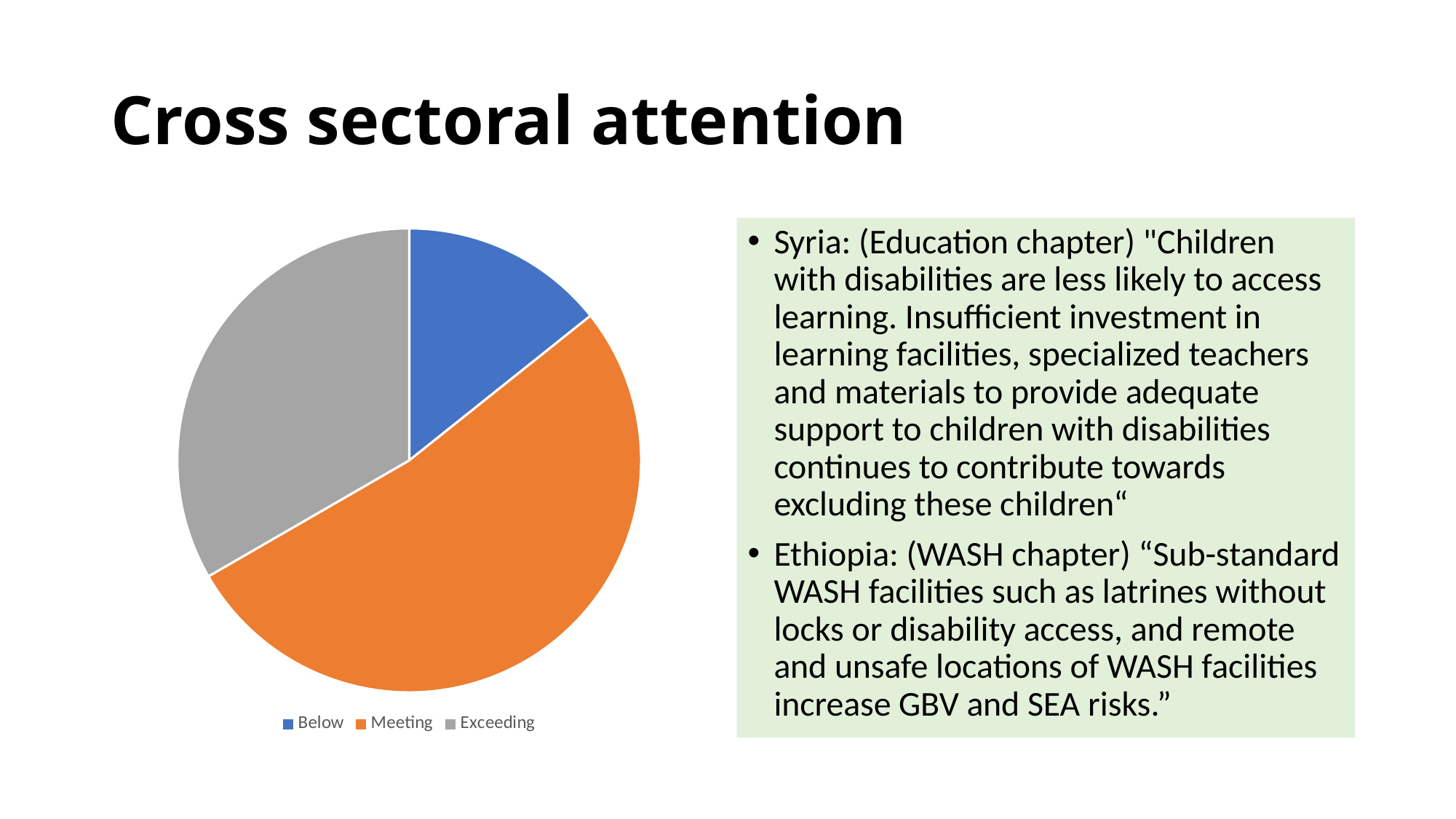
Which category has the largest slice in the pie chart? Meeting Which category has the smallest slice in the pie chart? Below Which category is shown in grey in the pie chart? Exceeding How many slices does the pie chart have? 3 How many entries does the legend of the pie chart list? 3 Which slice is larger in the pie chart, Exceeding or Below? Exceeding What kind of chart is shown on the slide? pie chart What colour is the Meeting slice in the pie chart? orange Which slice is larger in the pie chart, Meeting or Exceeding? Meeting